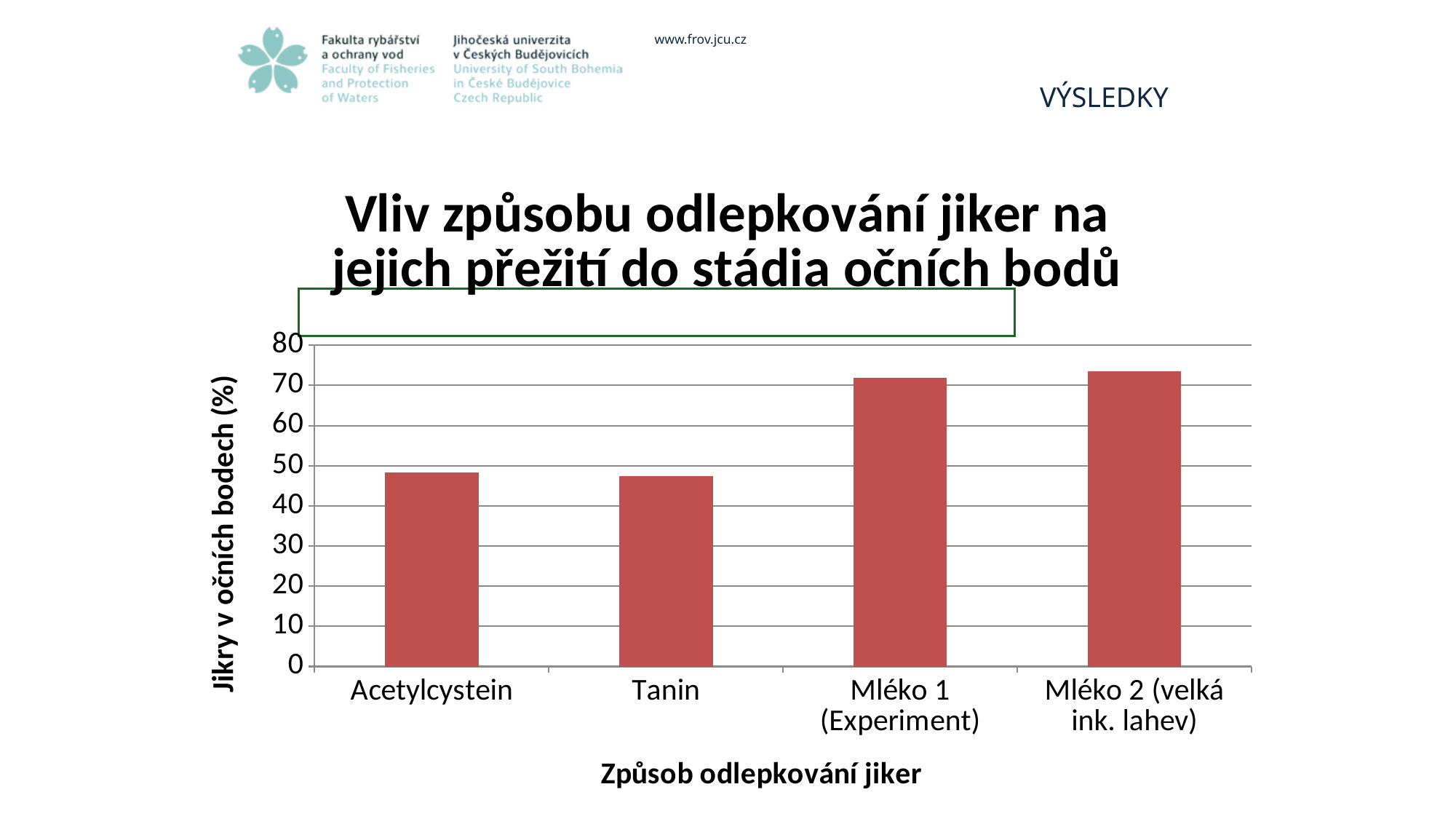
Which has a higher value, Tanin or Mléko 2 (velká ink. lahev)? Mléko 2 (velká ink. lahev) Is the value for Acetylcystein greater or less than 50? less What is the label of the y axis of the chart? Jikry v očních bodech (%) Is the value for Tanin greater or less than 50? less Is the value for Acetylcystein greater or less than 40? greater What is the label of the x axis of the chart? Způsob odlepkování jiker How many categories (methods) are shown on the x axis of the chart? 4 What kind of chart is shown on the slide? bar chart Which has a higher value, Acetylcystein or Mléko 1 (Experiment)? Mléko 1 (Experiment)